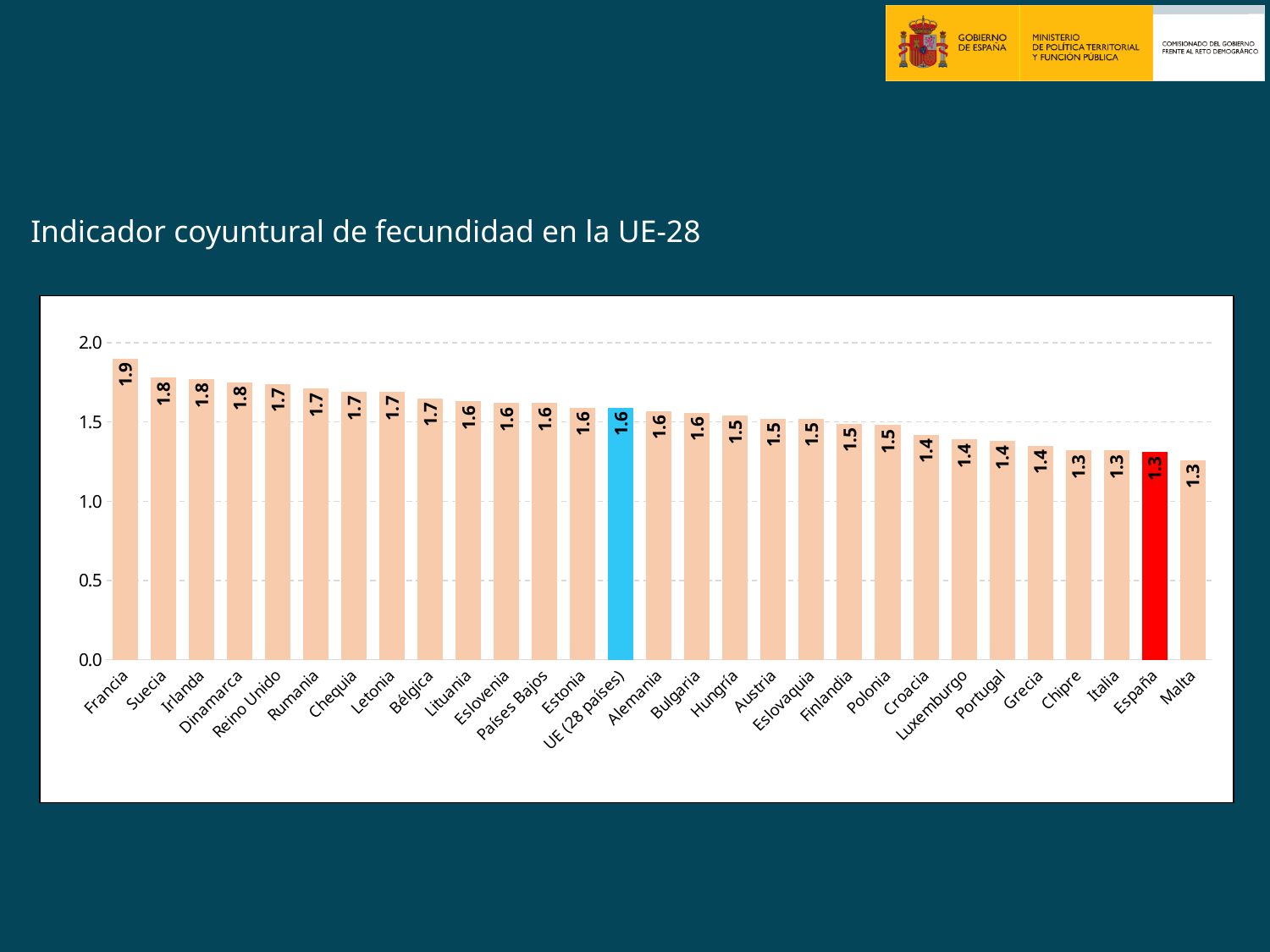
What colour is the bar for España? red What is the difference between the values for Francia and España? 0.6 What is the value for Polonia? 1.5 Which is larger, the value for Suecia or the value for Portugal? Suecia Is the value for Malta greater or less than 1.5? less What is the value for España? 1.3 Which category has the highest value? Francia How many bars are plotted in the chart? 29 What is the value for Francia? 1.9 Do the values rise or fall from left to right along the x axis? fall What kind of chart is shown on the slide? bar chart What is the value for UE (28 países)? 1.6